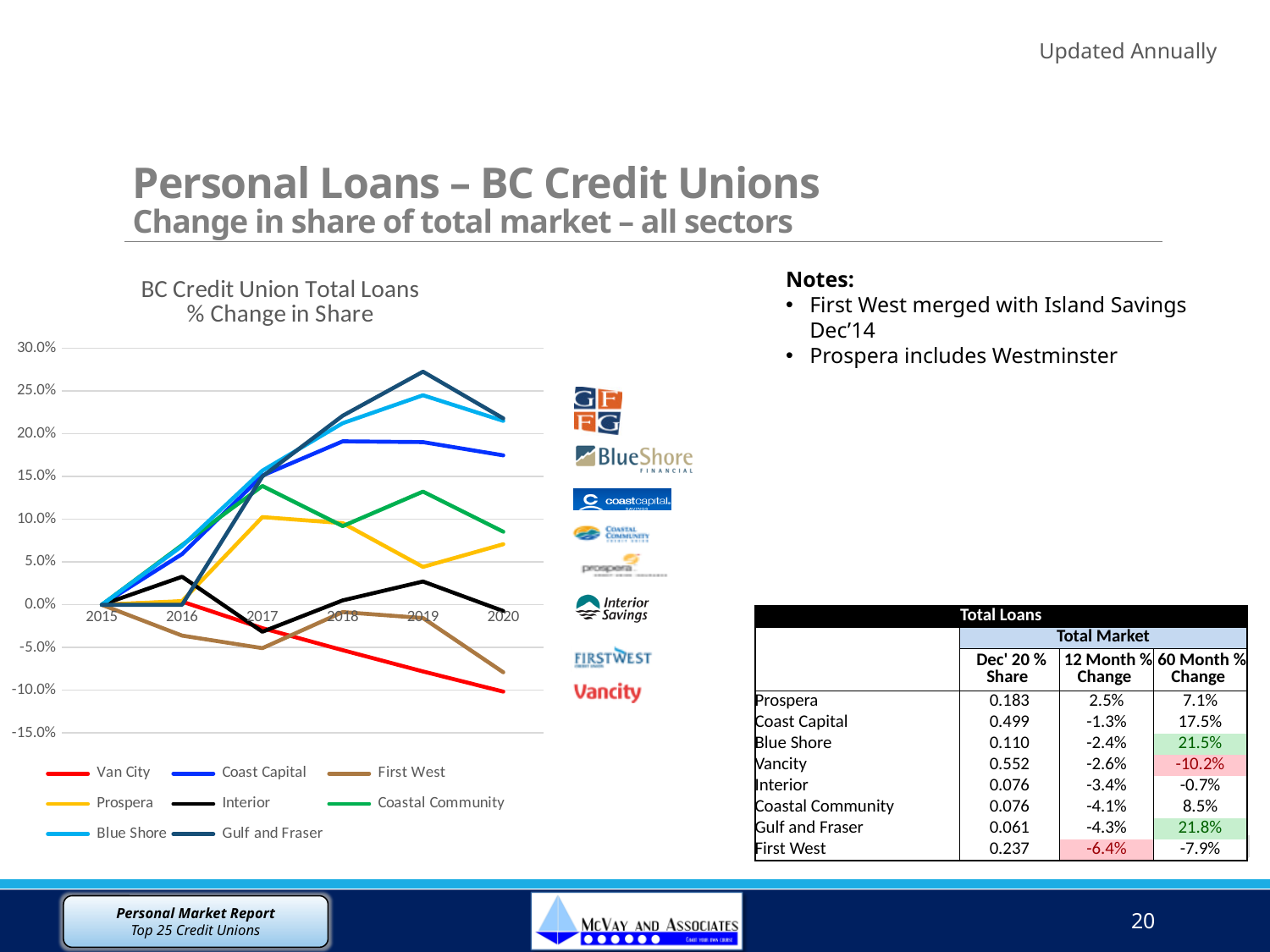
Is the value for Coast Capital in 2020 greater or less than 15.0%? greater Is the value for Coastal Community in 2019 greater or less than 10.0%? greater Which series has the highest value in 2019? Gulf and Fraser Is the value for Van City in 2020 greater or less than -5.0%? less What kind of chart is shown on the slide? line chart How many series does the legend of the chart list? 8 How many years are shown on the x axis of the chart? 6 Which series has the lowest value in 2020? Van City In 2020, which is larger: Coast Capital or Prospera? Coast Capital Does the Van City line rise or fall from 2015 to 2020? fall What colour is the Van City line in the chart? red What is the title of the chart? BC Credit Union Total Loans % Change in Share